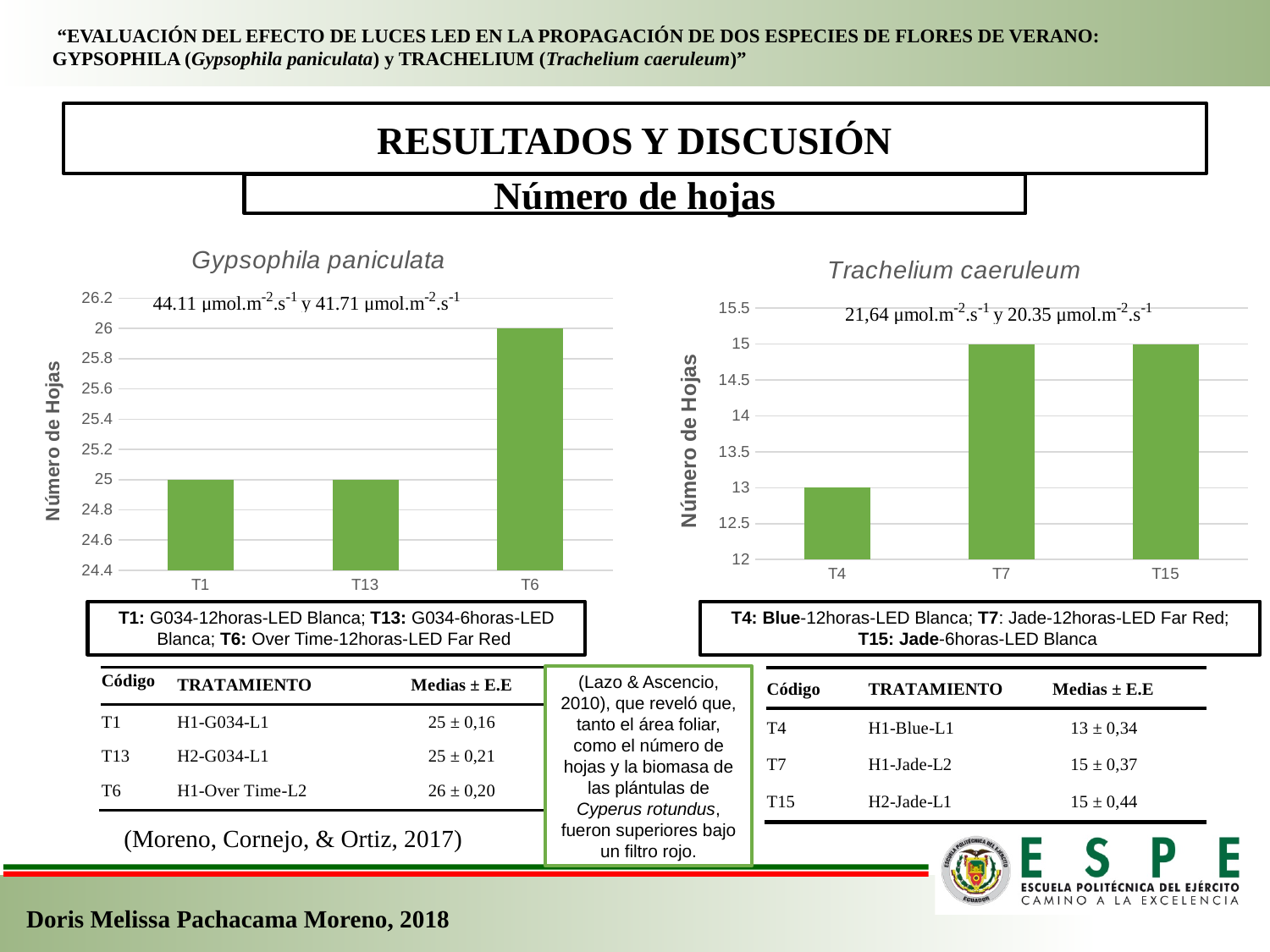
In the Trachelium caeruleum chart, what is the value for T7? 15 In the Trachelium caeruleum chart, what is the value for T4? 13 In the Trachelium caeruleum chart, which treatment has the lowest number of leaves? T4 What is the y-axis label of the Gypsophila paniculata chart? Número de Hojas In the Gypsophila paniculata chart, how many treatments are plotted? 3 In the Gypsophila paniculata chart, what is the value for T6? 26 What kind of chart is the Trachelium caeruleum chart? Bar chart In the Gypsophila paniculata chart, what is the difference between the values for T6 and T13? 1 In the Trachelium caeruleum chart, which is larger, the value for T4 or the value for T15? T15 In the Gypsophila paniculata chart, which treatment has the highest number of leaves? T6 In the Trachelium caeruleum chart, what is the difference between the values for T7 and T4? 2 In the Gypsophila paniculata chart, what is the value for T1? 25